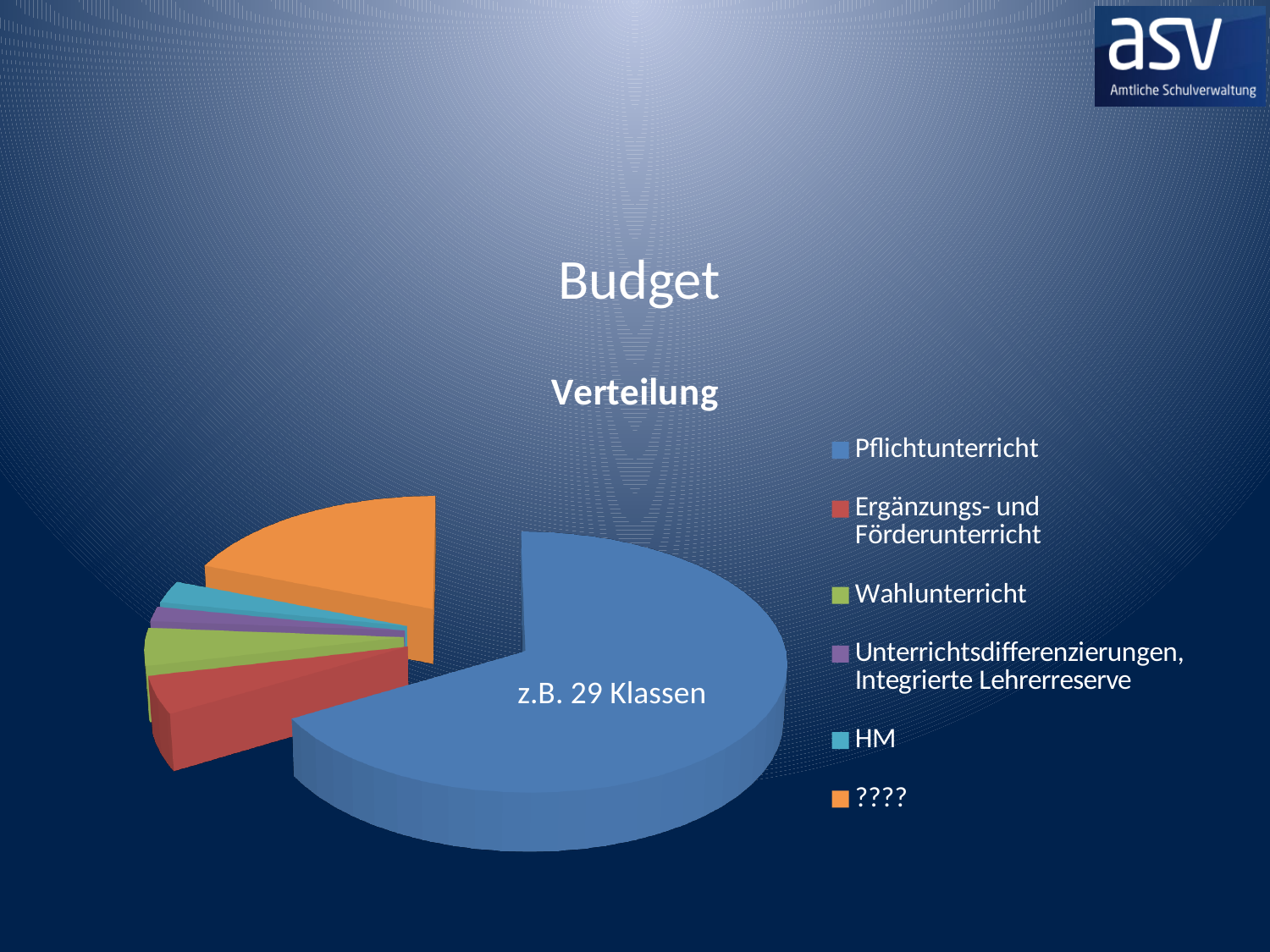
How many categories does the pie chart's legend list? 6 Which slice is larger, ???? or Wahlunterricht? ???? Which category has the largest slice of the pie? Pflichtunterricht Which slice is larger, Pflichtunterricht or ????? Pflichtunterricht Which category is shown in orange in the pie chart? ???? What text label is printed on the largest slice of the pie? z.B. 29 Klassen What kind of chart is shown on the slide? pie chart Which slice is larger, Ergänzungs- und Förderunterricht or HM? Ergänzungs- und Förderunterricht What is the title of the chart? Verteilung